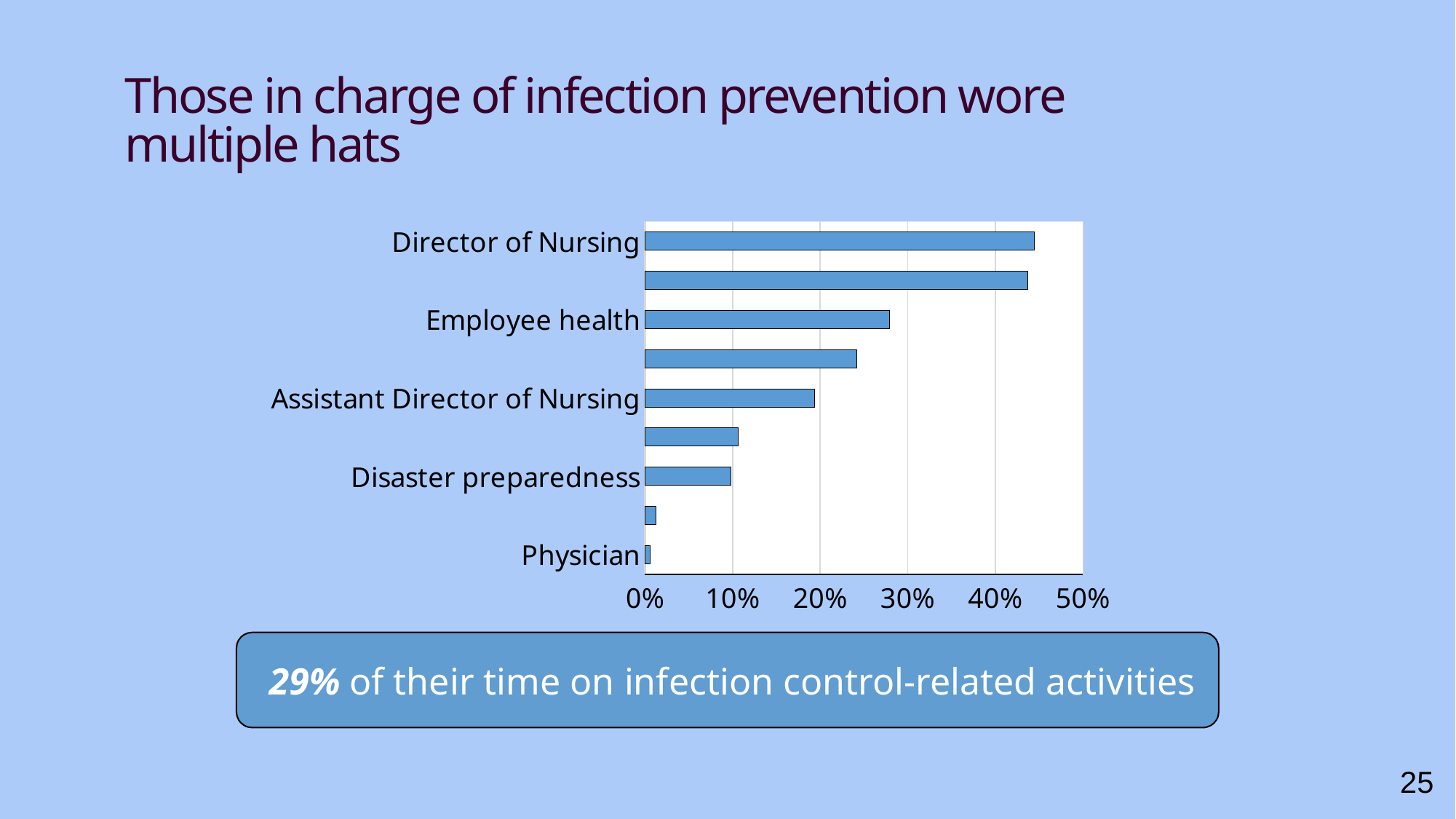
Is the value for Employee health greater or less than 30%? less How many bars are plotted in the chart? 9 Which is larger, the value for Employee health or the value for Assistant Director of Nursing? Employee health What is the title of the slide containing the chart? Those in charge of infection prevention wore multiple hats Is the value for Assistant Director of Nursing greater or less than 10%? greater Is the value for Director of Nursing greater or less than 40%? greater Which labeled category has the shortest bar? Physician What kind of chart is shown on the slide? bar chart Which labeled category has the longest bar? Director of Nursing